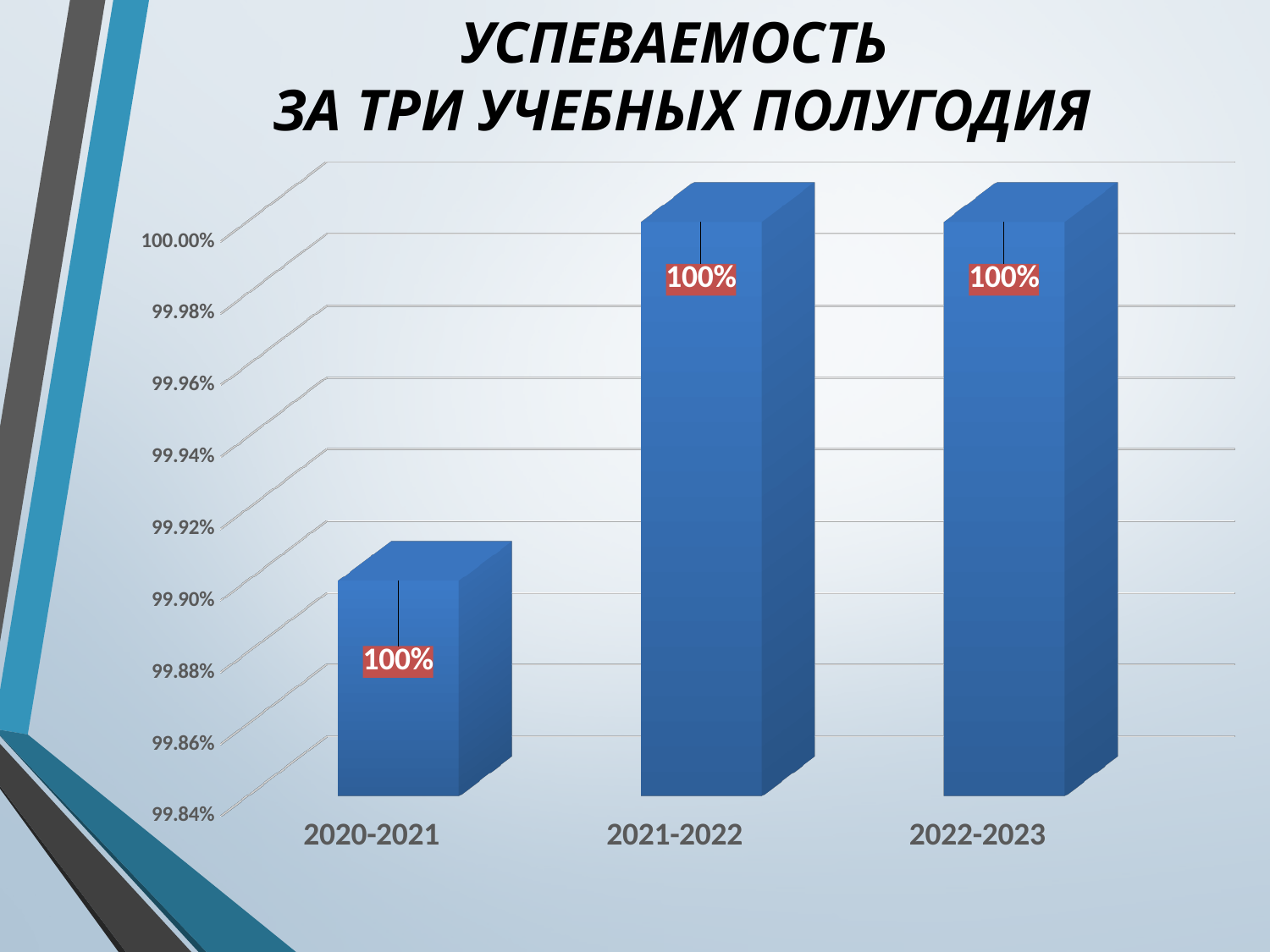
What is the title of the slide? УСПЕВАЕМОСТЬ ЗА ТРИ УЧЕБНЫХ ПОЛУГОДИЯ Is the top of the bar for 2020-2021 greater or less than 99.94%? less What kind of chart is shown on the slide? bar chart Does the bar height rise or fall from 2020-2021 to 2021-2022? rise What is the data label shown on the bar for 2020-2021? 100% Is the top of the bar for 2020-2021 greater or less than 99.86%? greater How many categories are shown on the x axis? 3 What is the data label shown on the bar for 2021-2022? 100% Which bar is taller, 2020-2021 or 2021-2022? 2021-2022 What is the data label shown on the bar for 2022-2023? 100% Which category has the lowest bar on the chart? 2020-2021 What is the lowest value shown on the y axis? 99.84%